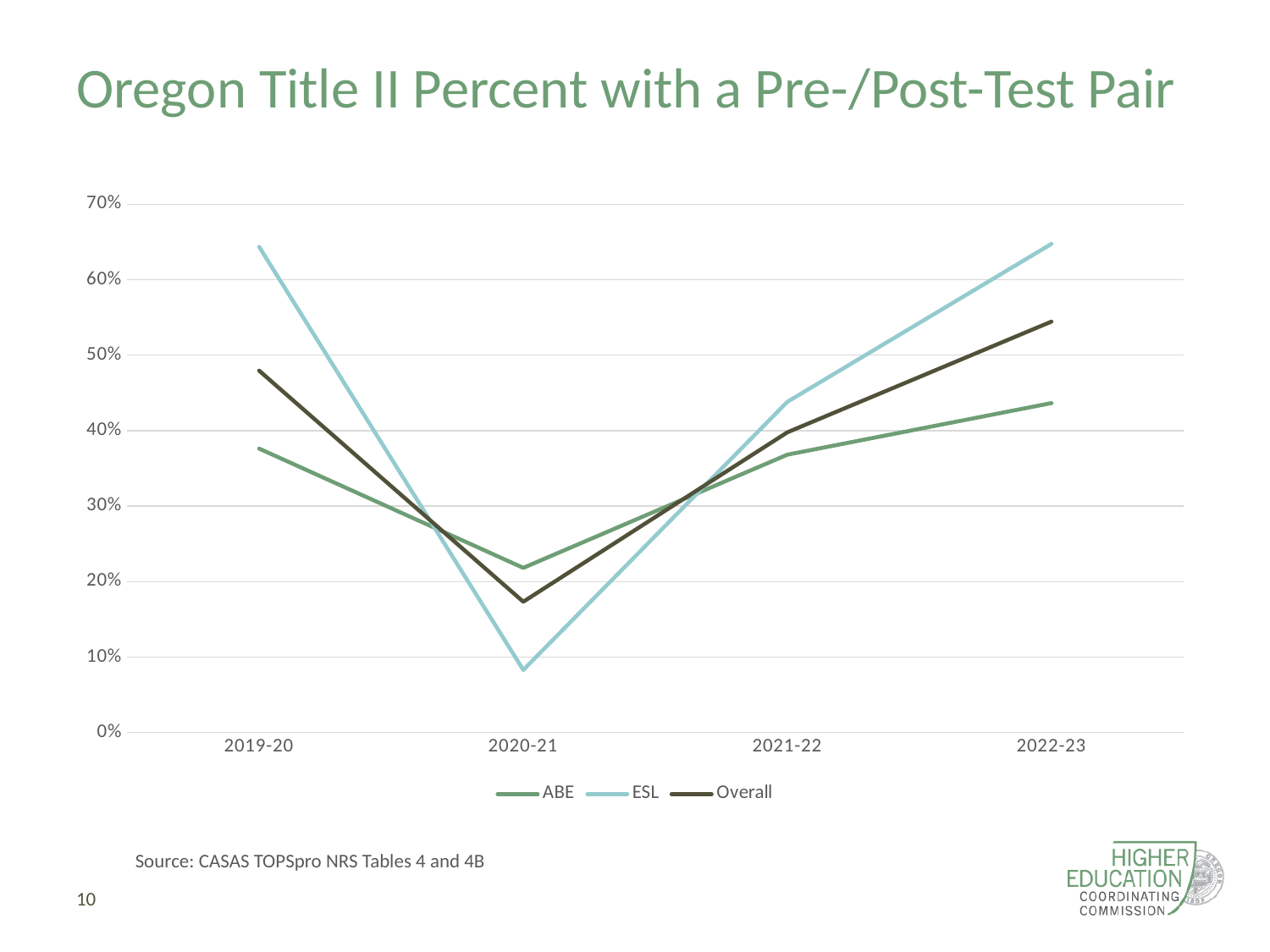
What is the title of the chart? Oregon Title II Percent with a Pre-/Post-Test Pair In which year is the ESL value lowest? 2020-21 How many program years are shown on the x axis? 4 Which series has the higher value in 2022-23, ABE or ESL? ESL Do the values for all three series rise or fall from 2020-21 to 2022-23? rise In which year is the ESL value highest? 2022-23 What kind of chart is shown on the slide? line chart Is the ESL value for 2020-21 greater or less than 10%? less Is the Overall value for 2022-23 greater or less than 50%? greater How many series does the legend list? 3 Is the ESL value for 2019-20 greater or less than 60%? greater